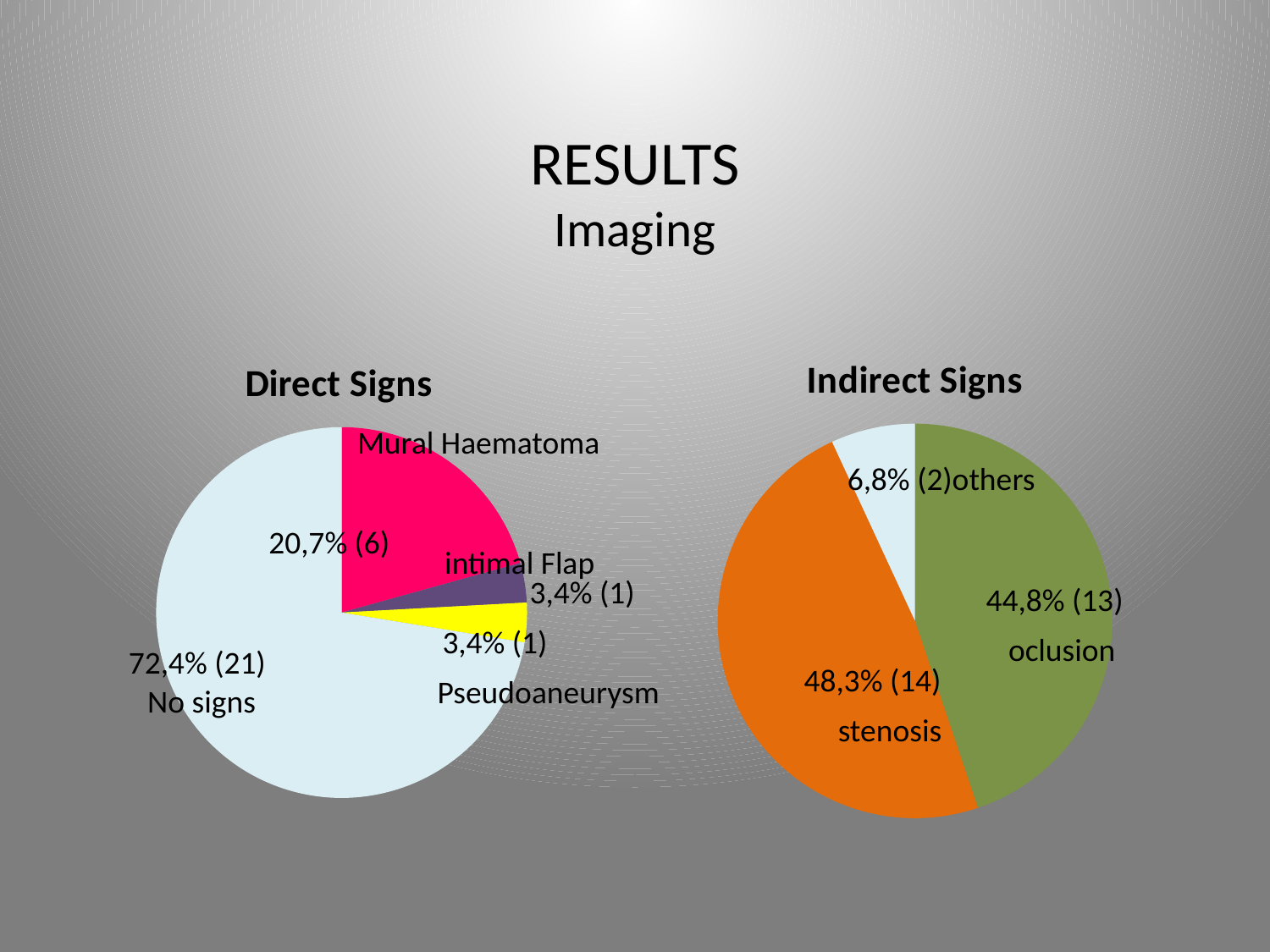
In the Direct Signs chart, what is the value shown for Pseudoaneurysm? 3,4% (1) In the Indirect Signs chart, what is the value shown for stenosis? 48,3% (14) In the Indirect Signs chart, which category has the smallest slice? others In the Direct Signs chart, which category has the largest slice? No signs What kind of chart is the Direct Signs chart? Pie chart In the Direct Signs chart, what colour is the Mural Haematoma slice? Pink In the Indirect Signs chart, how many slices does the pie have? 3 In the Direct Signs chart, how many slices does the pie have? 4 In the Indirect Signs chart, what is the value shown for oclusion? 44,8% (13) In the Direct Signs chart, what share of the pie is labelled No signs? 72,4% (21) In the Indirect Signs chart, what is the difference in count between stenosis and oclusion? 1 In the Direct Signs chart, what is the value shown for Mural Haematoma? 20,7% (6)